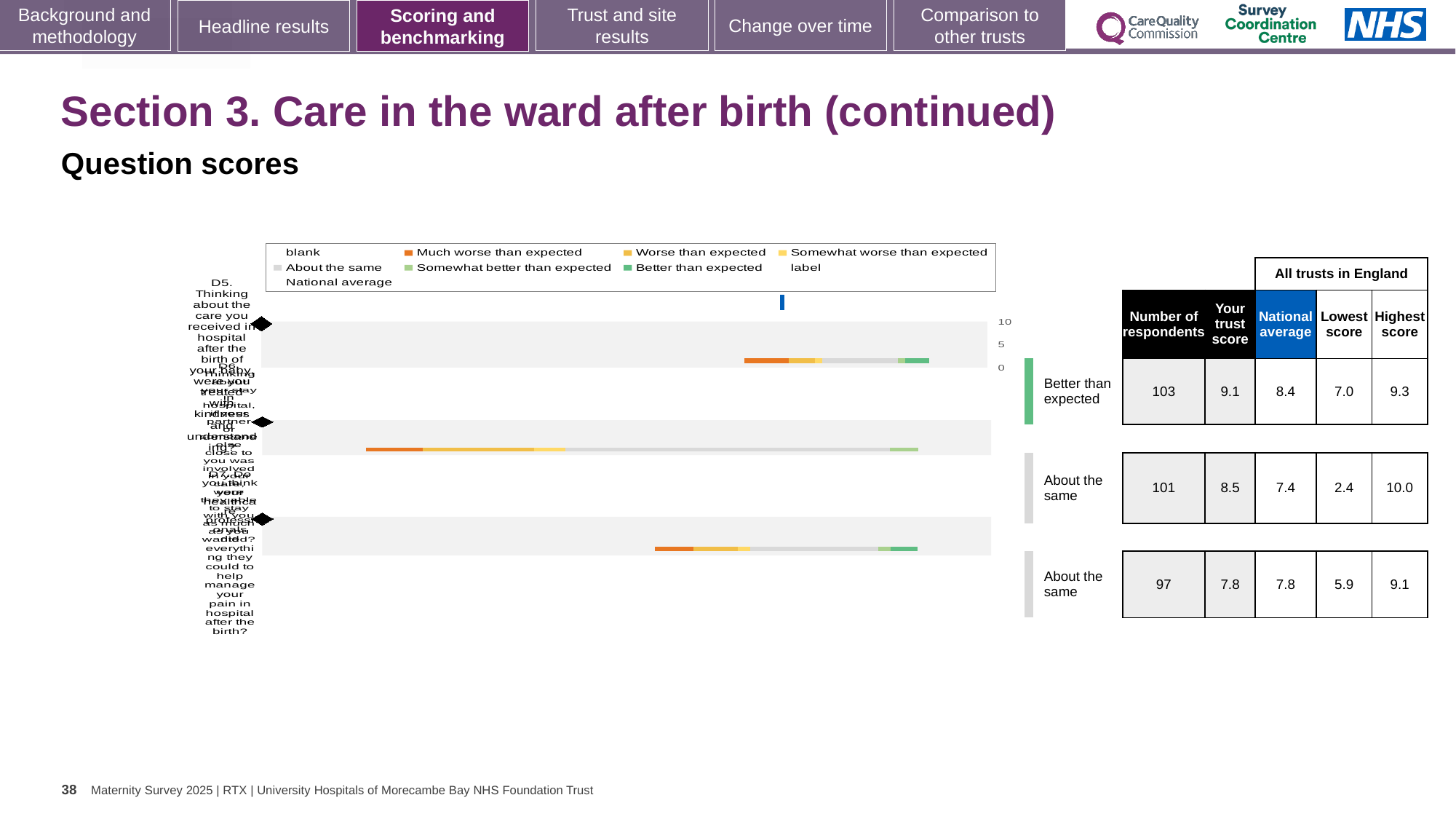
In the table beside the chart, what is 'Your trust score' for the first question row (D5)? 9.1 In the table beside the chart, how many respondents are listed for the first question row (D5)? 103 For the first question row (D5), what is the difference between the trust score (9.1) and the national average (8.4)? 0.7 Which question row has the highest 'Highest score' value in the table beside the chart? the second row (10.0) What colour does the legend use for 'Much worse than expected'? orange In the table beside the chart, what is the national average for the first question row (D5)? 8.4 What benchmark label is shown next to the first question row (D5)? Better than expected What kind of chart is shown on the slide? bar chart How many question bars are plotted in the chart? 3 What is the highest tick value shown on the chart's axis? 10 How many entries does the chart's legend list? 9 For the first question row (D5), which is larger: the trust score or the national average? the trust score